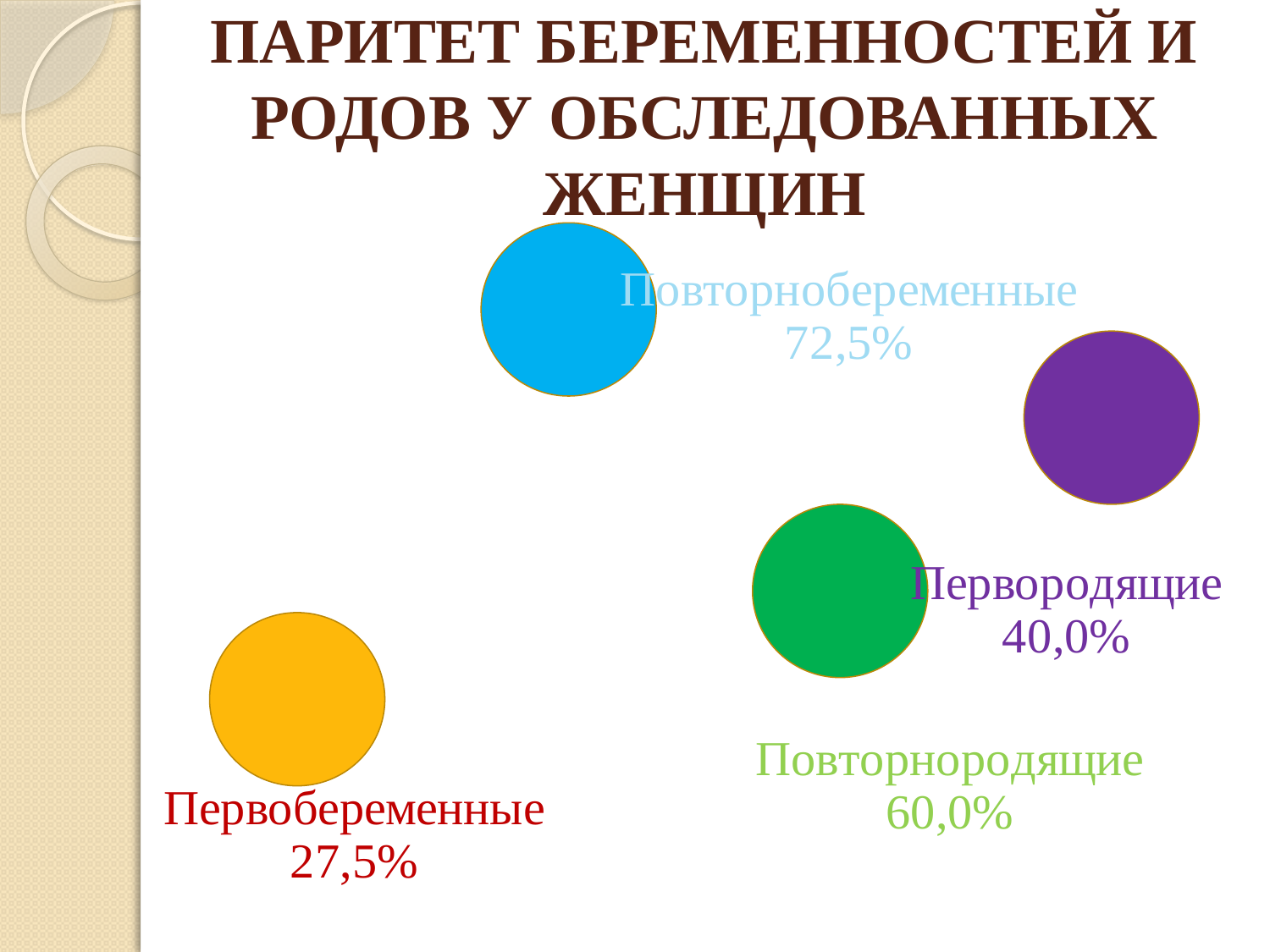
What is the value shown for Повторнобеременные? 72,5% What is the value shown for Первобеременные? 27,5% How many categories are shown on the chart? 4 Which category has the lowest value on the slide? Первобеременные Which category has the highest value on the slide? Повторнобеременные What kind of chart is shown on the slide? Bubble chart What is the title of the slide? ПАРИТЕТ БЕРЕМЕННОСТЕЙ И РОДОВ У ОБСЛЕДОВАННЫХ ЖЕНЩИН What is the value shown for Первородящие? 40,0% What is the difference between the values for Повторнобеременные and Первобеременные? 45,0% Which is larger, the value for Первородящие or the value for Повторнородящие? Повторнородящие What is the difference between the values for Повторнородящие and Первородящие? 20,0% What is the value shown for Повторнородящие? 60,0%